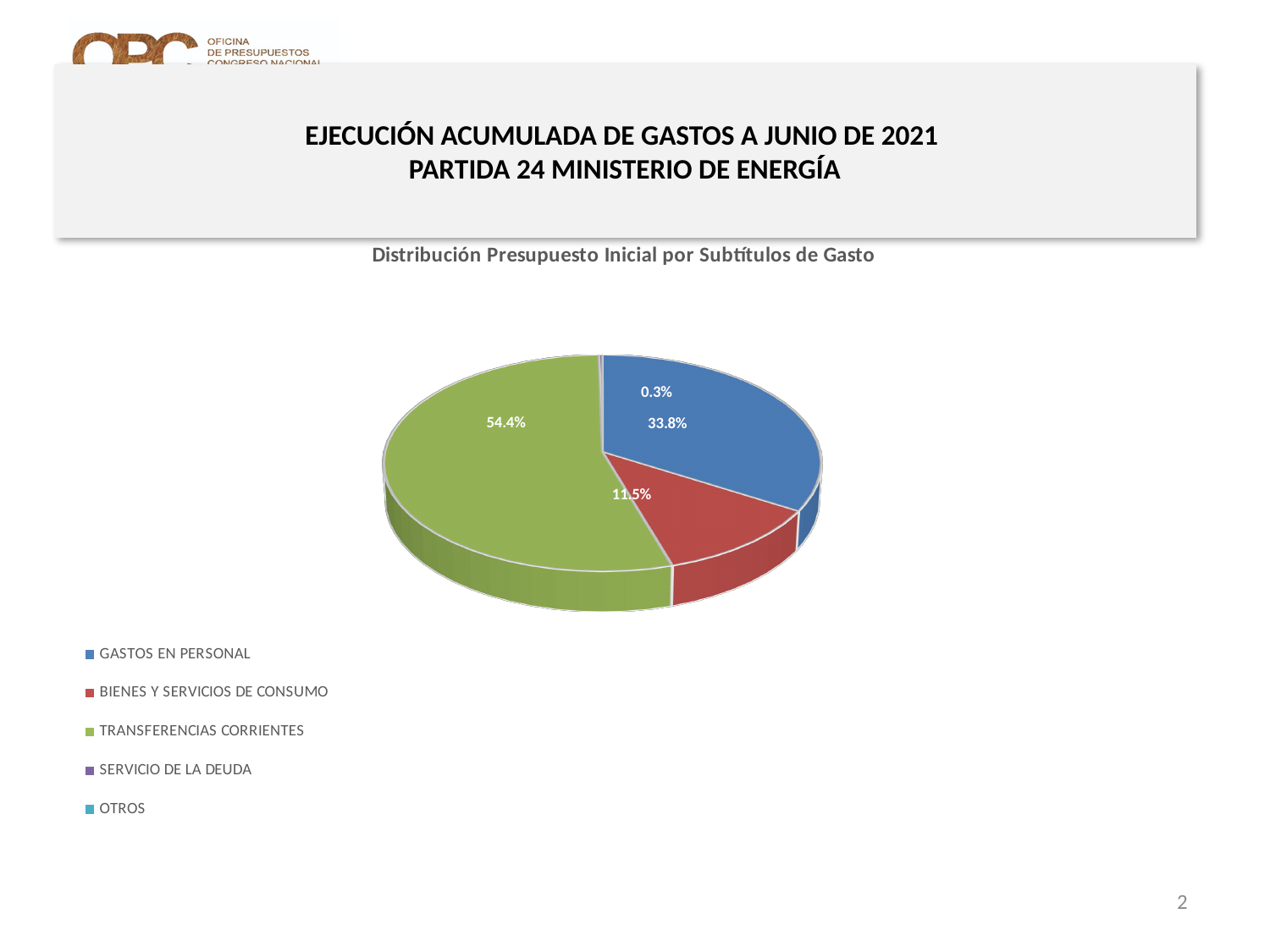
What is the title of the chart? Distribución Presupuesto Inicial por Subtítulos de Gasto Which category has the largest share of the pie? TRANSFERENCIAS CORRIENTES How many categories does the legend list? 5 Which has the larger share: GASTOS EN PERSONAL or BIENES Y SERVICIOS DE CONSUMO? GASTOS EN PERSONAL Is the share for TRANSFERENCIAS CORRIENTES greater or less than 50%? greater What kind of chart is shown on the slide? Pie chart What percentage of the pie does BIENES Y SERVICIOS DE CONSUMO represent? 11.5% How many percentage points larger is TRANSFERENCIAS CORRIENTES than GASTOS EN PERSONAL? 20.6 percentage points How many percentage points larger is GASTOS EN PERSONAL than BIENES Y SERVICIOS DE CONSUMO? 22.3 percentage points What percentage of the pie does GASTOS EN PERSONAL represent? 33.8% What percentage of the pie does TRANSFERENCIAS CORRIENTES represent? 54.4% What is the smallest percentage label shown on the pie chart? 0.3%